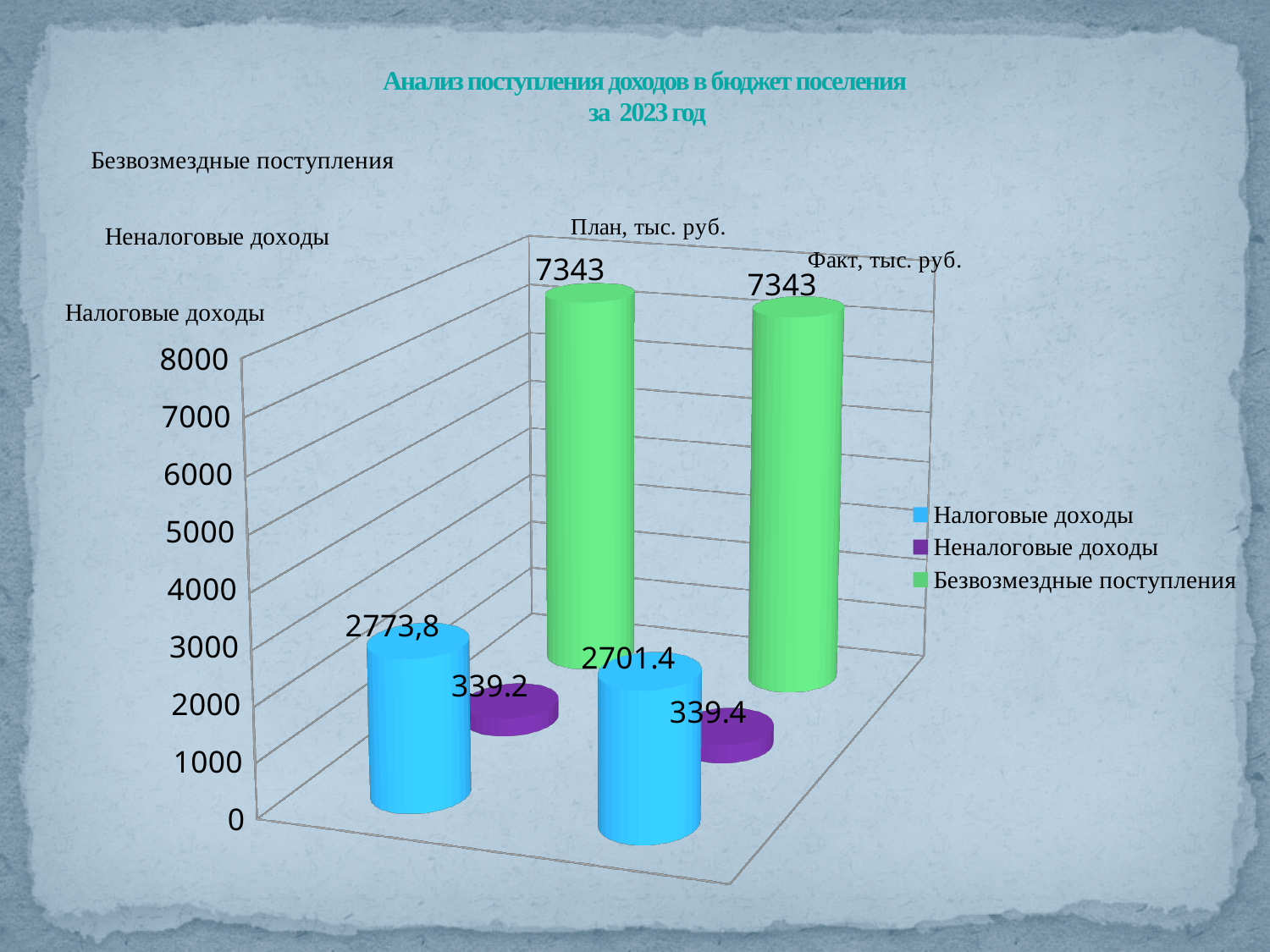
How many series does the legend list? 3 Which is larger: Налоговые доходы for План or Налоговые доходы for Факт? План What is the value of Неналоговые доходы for План, тыс. руб.? 339.2 What is the difference between the План and Факт values of Налоговые доходы? 72.4 What is the title of the chart? Анализ поступления доходов в бюджет поселения за 2023 год What is the value of Налоговые доходы for Факт, тыс. руб.? 2701.4 Which series has the lowest value for Факт, тыс. руб.? Неналоговые доходы What type of chart is shown on the slide? Bar chart What is the value of Безвозмездные поступления for Факт, тыс. руб.? 7343 Which series has the highest value for План, тыс. руб.? Безвозмездные поступления What is the value of Неналоговые доходы for Факт, тыс. руб.? 339.4 What is the value of Налоговые доходы for План, тыс. руб.? 2773,8